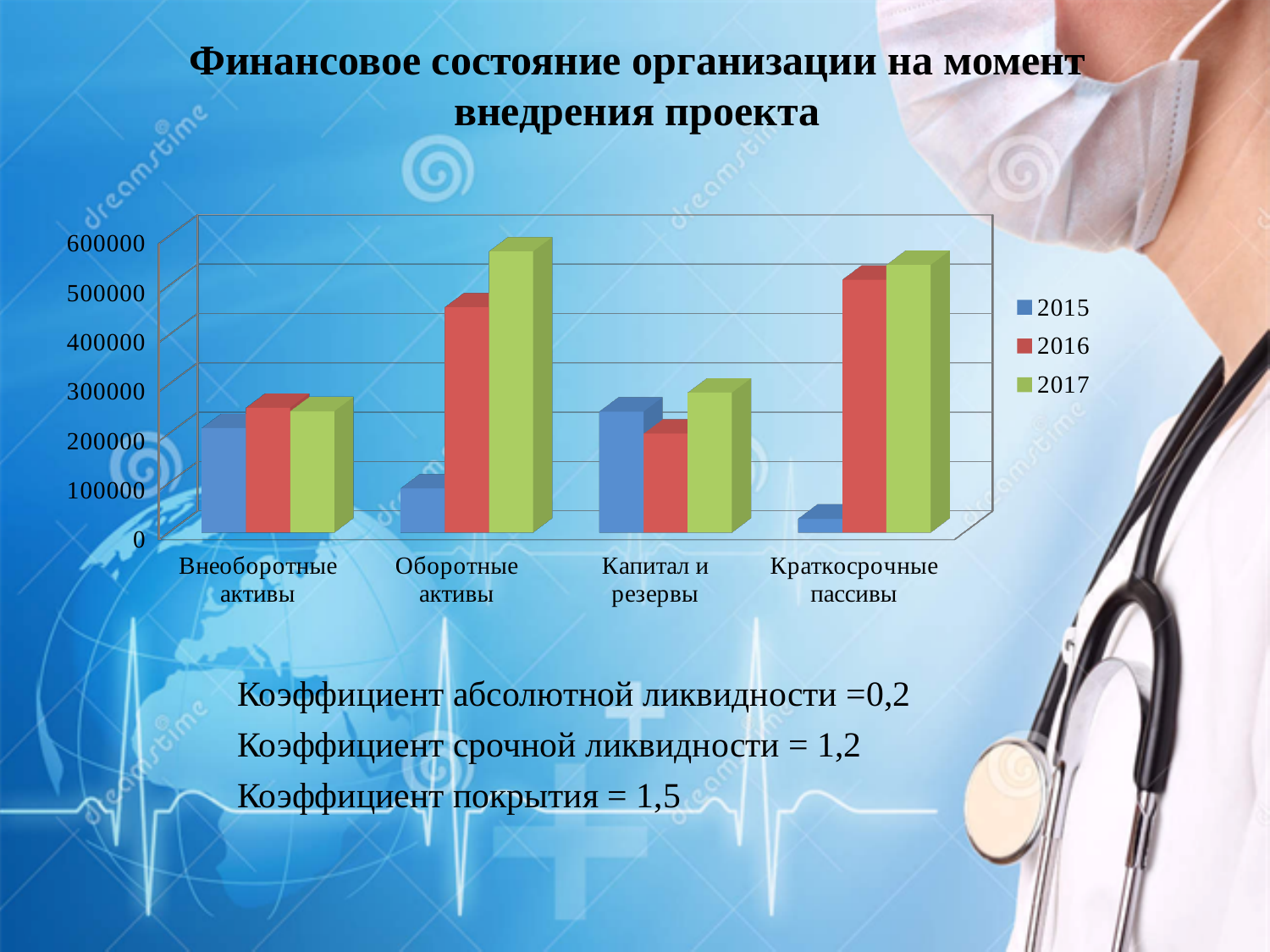
Is the 2016 value for Краткосрочные пассивы greater or less than 400000? greater What kind of chart is shown on the slide? bar chart How many categories are shown on the x axis of the chart? 4 Do the values for Оборотные активы rise or fall from 2015 to 2017? rise Is the 2017 value for Капитал и резервы greater or less than 400000? less Which category has the lowest value for 2015? Краткосрочные пассивы Is the 2015 value for Краткосрочные пассивы greater or less than 100000? less Which years are listed in the chart legend? 2015, 2016, 2017 How many series does the chart legend list? 3 For 2016, which is larger: Оборотные активы or Внеоборотные активы? Оборотные активы